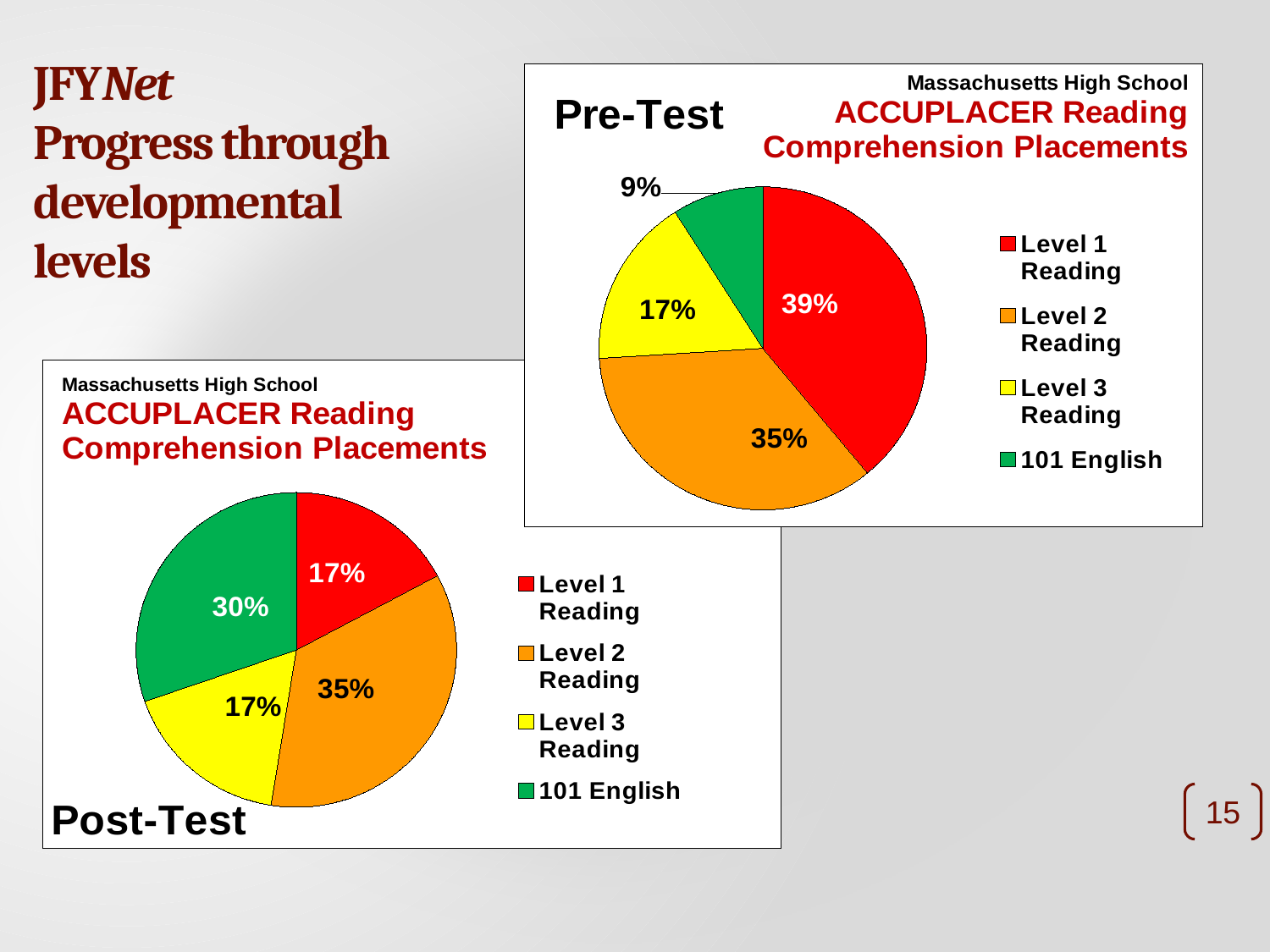
What type of chart is the Pre-Test chart? Pie chart How many categories does the Post-Test chart show? 4 In the Pre-Test chart, what share of placements is Level 1 Reading? 39% In the Post-Test chart, what share of placements is Level 2 Reading? 35% Is the Level 1 Reading share larger in the Pre-Test chart or the Post-Test chart? Pre-Test What is the difference between the 101 English share in the Post-Test chart and in the Pre-Test chart? 21 percentage points In the Pre-Test chart, which category has the largest slice? Level 1 Reading In the Pre-Test chart, which category has the smallest slice? 101 English In the Post-Test chart, what share of placements is 101 English? 30% In the Pre-Test chart, what colour represents Level 3 Reading? Yellow In the Pre-Test chart, what share of placements is 101 English? 9% In the Post-Test chart, which category has the largest slice? Level 2 Reading